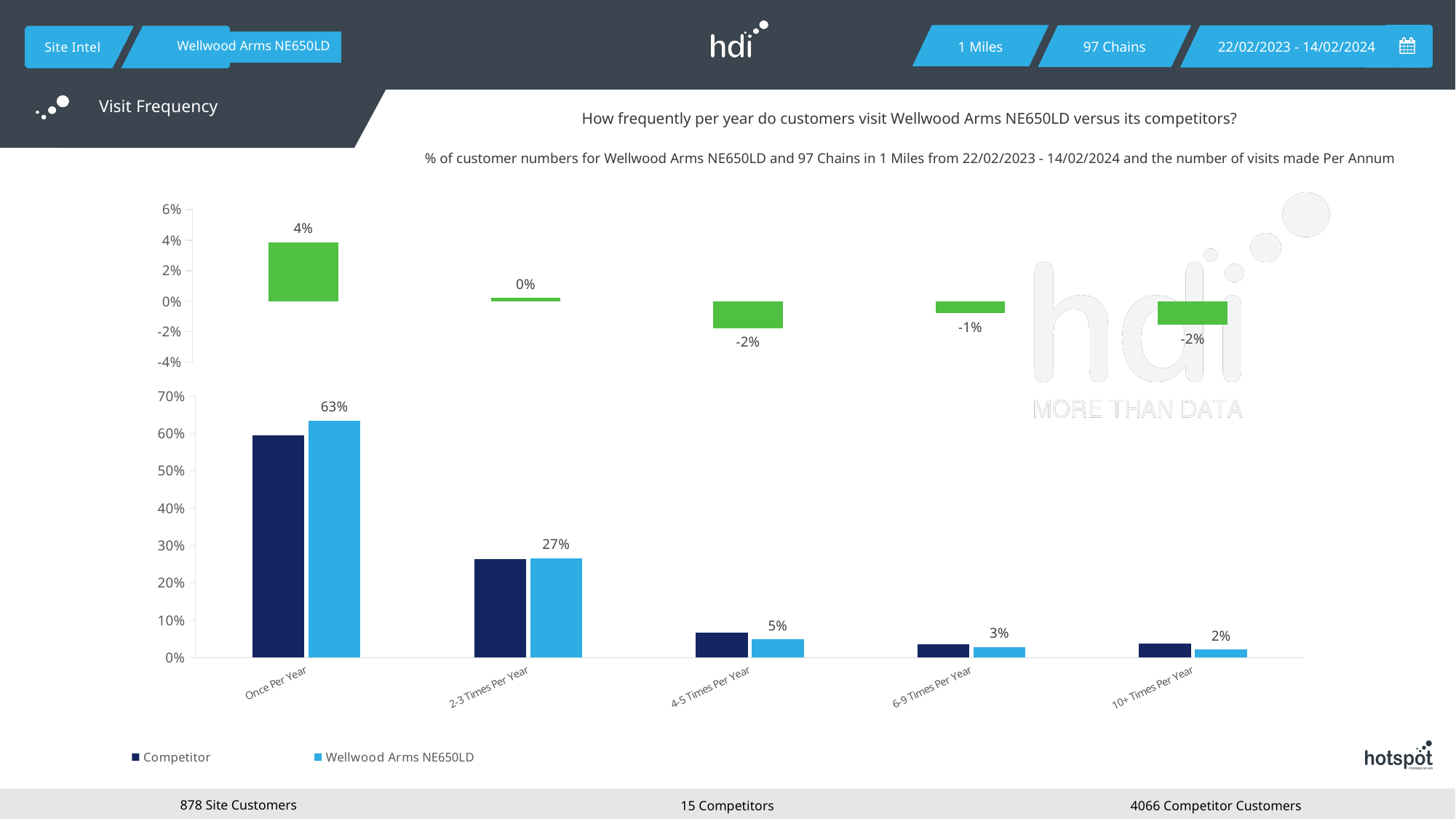
In the lower chart, what is the difference between the Wellwood Arms NE650LD values for Once Per Year and 2-3 Times Per Year? 36% How many series does the legend of the lower chart list? 2 In the lower chart, which is larger for Once Per Year: Competitor or Wellwood Arms NE650LD? Wellwood Arms NE650LD In the lower chart, which category has the lowest value for Wellwood Arms NE650LD? 10+ Times Per Year In the lower chart, what is the value for Wellwood Arms NE650LD for 10+ Times Per Year? 2% What kind of chart is the lower chart? Bar chart In the lower chart, is the Competitor value for Once Per Year greater or less than 50%? greater In the upper chart, what is the value shown for Once Per Year? 4% In the lower chart, which category has the highest value for Wellwood Arms NE650LD? Once Per Year In the lower chart, what is the value for Wellwood Arms NE650LD for Once Per Year? 63% In the upper chart, what is the value shown for 6-9 Times Per Year? -1% In the lower chart, what is the value for Wellwood Arms NE650LD for 2-3 Times Per Year? 27%